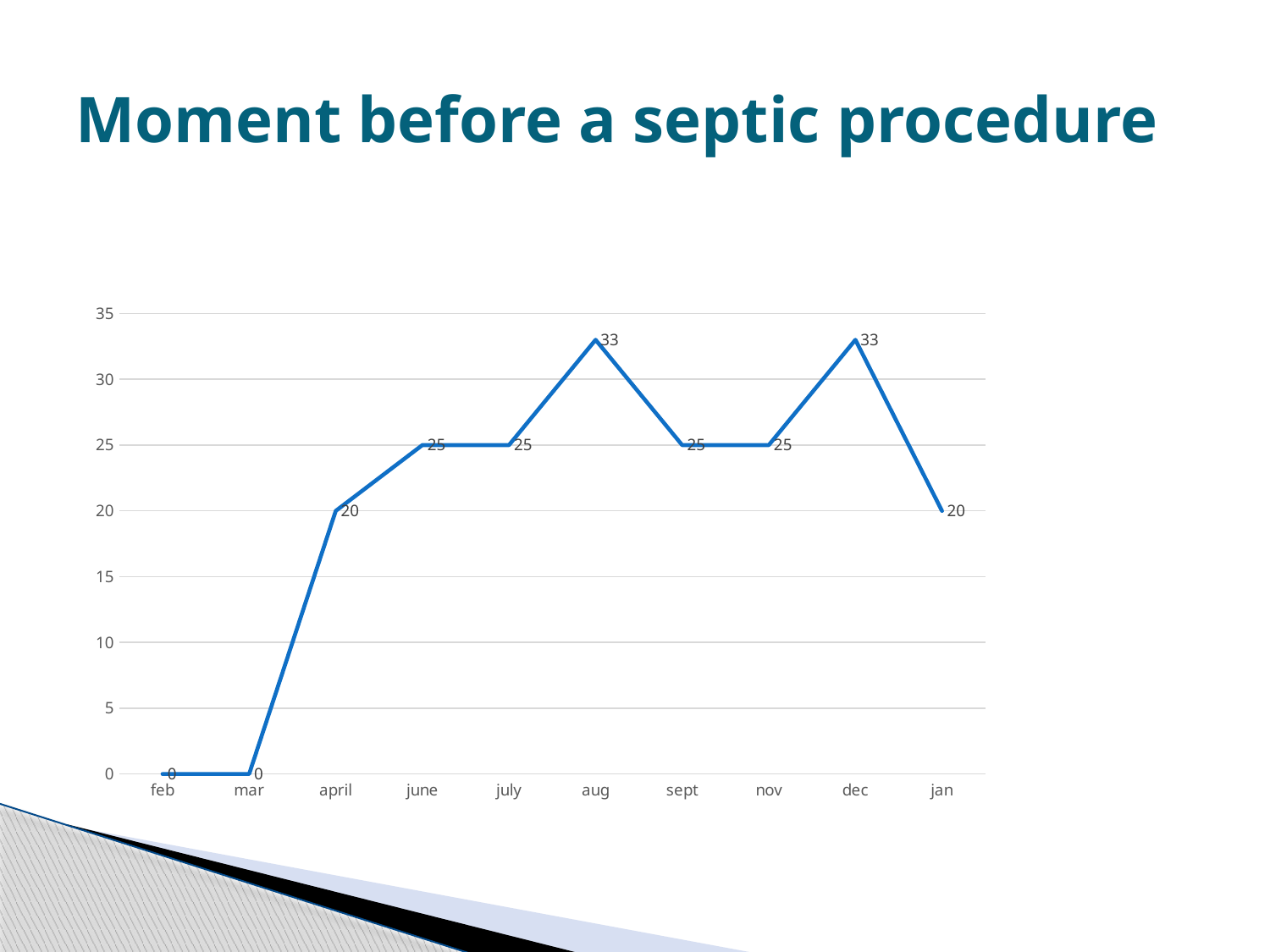
What is the value for april? 20 Which months have the lowest value? feb and mar What is the value for jan? 20 What is the difference between the values for aug and sept? 8 What is the value for aug? 33 Which is larger, the value for june or the value for april? june What is the title of the slide? Moment before a septic procedure What kind of chart is shown on the slide? line chart Is the value for dec greater or less than 30? greater How many months are shown on the x axis? 10 Which months have the highest value? aug and dec What is the value for feb? 0